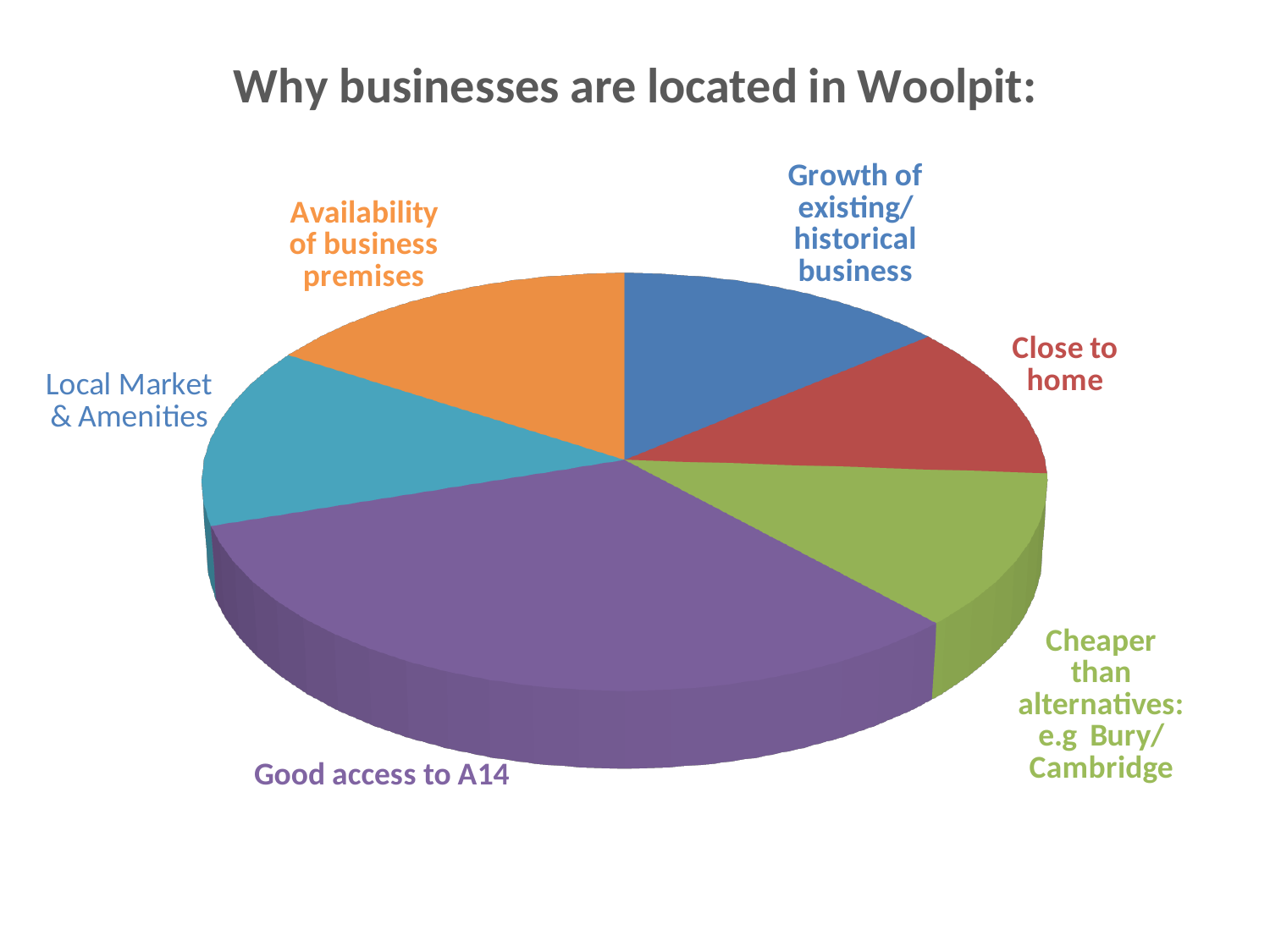
Which slice is larger: Good access to A14 or Local Market & Amenities? Good access to A14 How many slices does the pie chart have? 6 Which slice is larger: Good access to A14 or Cheaper than alternatives: e.g Bury/Cambridge? Good access to A14 Which reason has the largest slice of the pie chart? Good access to A14 Which slice is larger: Availability of business premises or Close to home? Availability of business premises What kind of chart is shown on the slide? pie chart What colour is the slice for Good access to A14? purple What is the title of the chart? Why businesses are located in Woolpit: